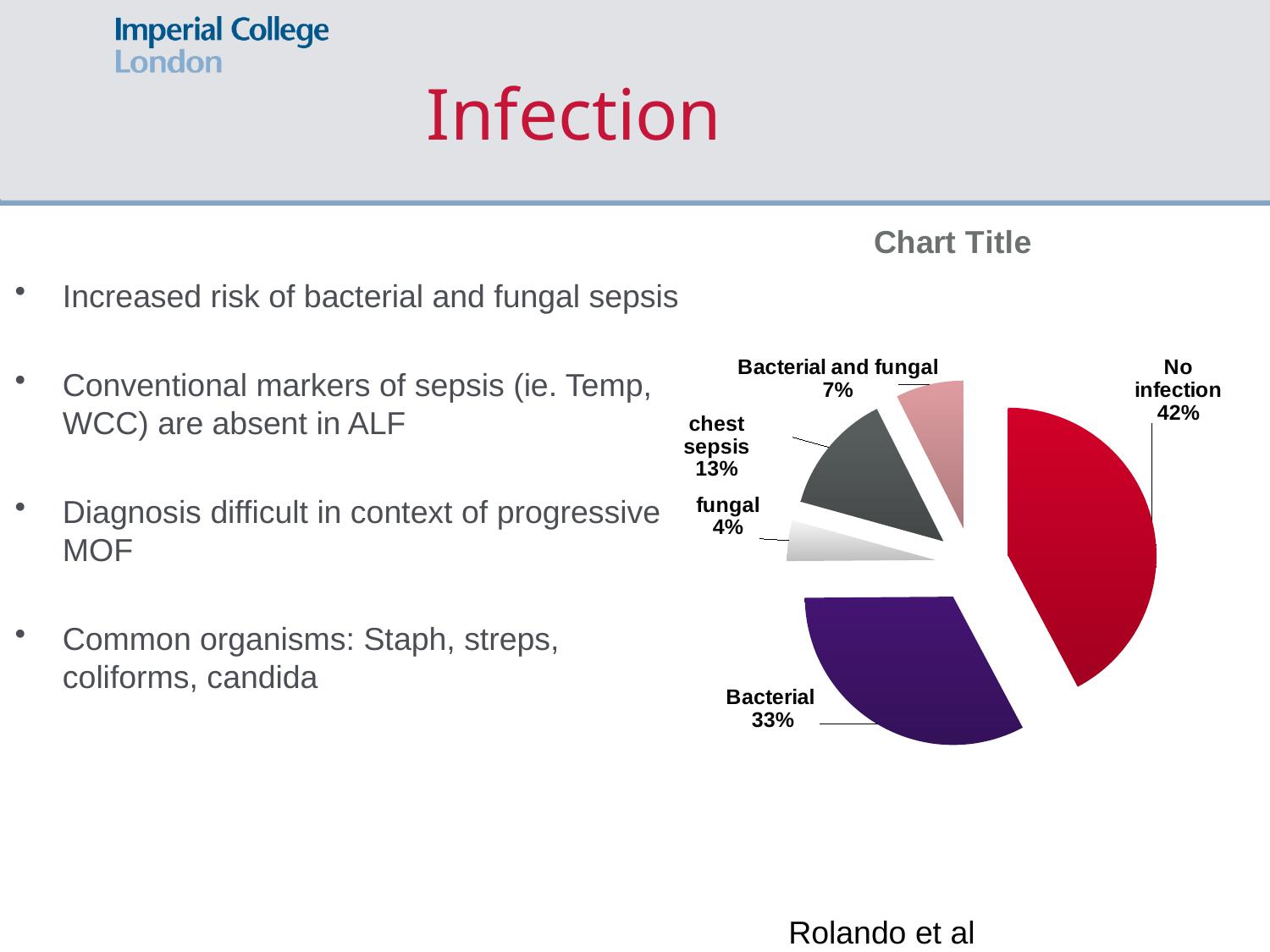
What percentage of the pie is labelled "fungal"? 4% What percentage of the pie is labelled "Bacterial"? 33% What is the title shown above the pie chart? Chart Title Which slice of the pie is the smallest? fungal Which slice is larger, "chest sepsis" or "Bacterial and fungal"? chest sepsis What type of chart is shown on the slide? Pie chart What percentage of the pie is labelled "No infection"? 42% How many slices does the pie chart have? 5 Which slice of the pie is the largest? No infection What is the difference in percentage points between the "No infection" and "Bacterial" slices? 9 What percentage of the pie is labelled "Bacterial and fungal"? 7% What percentage of the pie is labelled "chest sepsis"? 13%